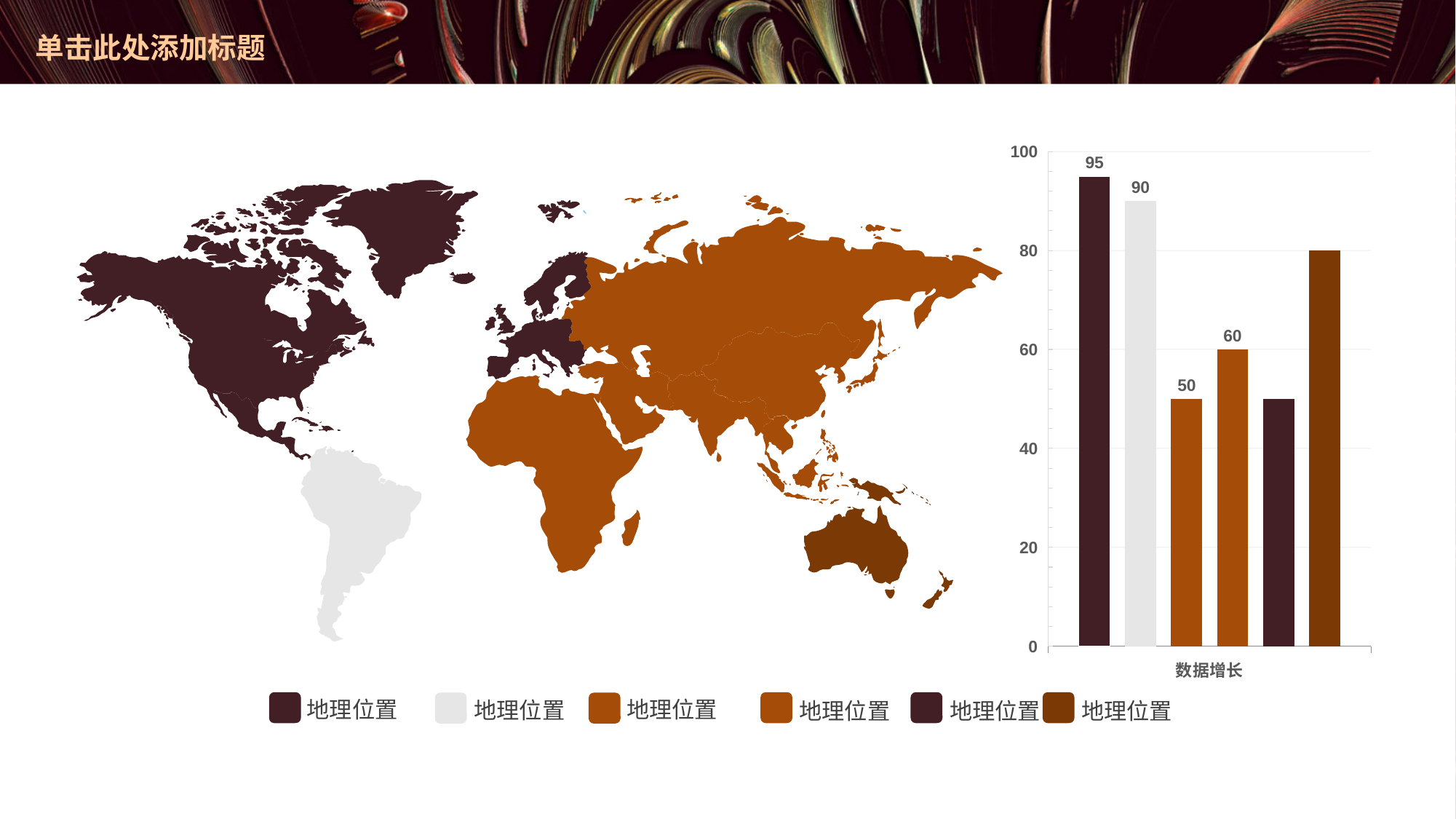
Which is larger, the value of the third bar or the value of the fourth bar? the fourth bar (60) What is the difference between the first bar (95) and the second bar (90)? 5 Is the value of the fifth bar greater or less than 60? less Which bar in the chart has the highest value? the first (leftmost) bar, 95 What is the category label shown on the x axis of the chart? 数据增长 Is the value of the sixth (rightmost) bar greater or less than 60? greater What is the value shown on the second bar (the light grey one) of the chart? 90 What is the value shown on the third bar of the chart? 50 What type of chart is shown on the right side of the slide? bar chart What is the value shown on the fourth bar of the chart? 60 What is the value shown on the first (leftmost) bar of the chart? 95 How many series does the legend list for the chart? 6